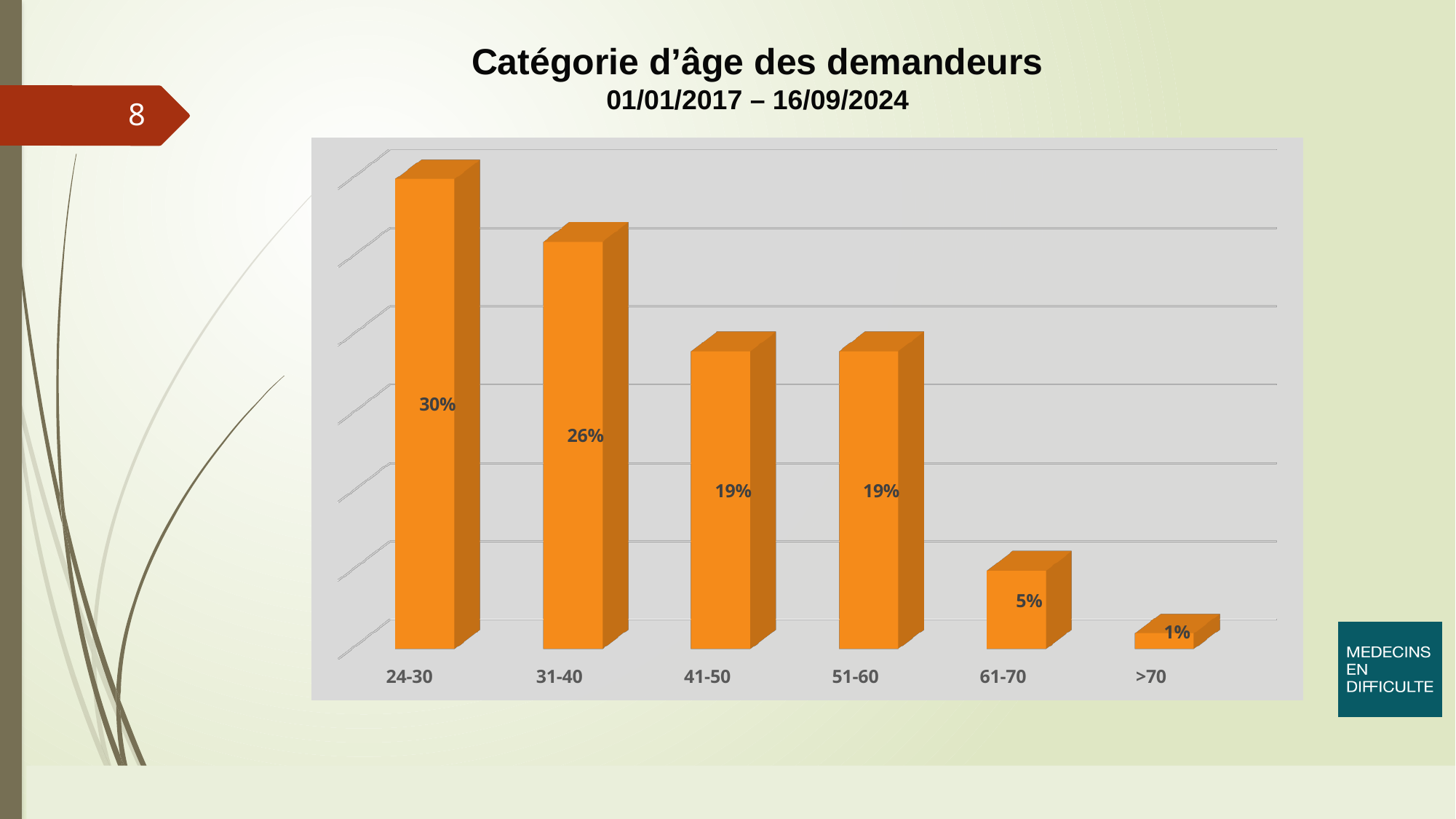
What is the difference in percentage points between the 24-30 and 31-40 age categories? 4 Which age category has the highest share of applicants? 24-30 Which age category has a larger share of applicants, 31-40 or 51-60? 31-40 What percentage of applicants are in the 24-30 age category? 30% What percentage of applicants are in the >70 age category? 1% What is the title of the chart on the slide? Catégorie d’âge des demandeurs What percentage of applicants are in the 61-70 age category? 5% How many age categories are shown on the chart? 6 What percentage of applicants are in the 31-40 age category? 26% Which age category has the lowest share of applicants? >70 What type of chart is shown on the slide? Bar chart What is the difference in percentage points between the 41-50 and 61-70 age categories? 14